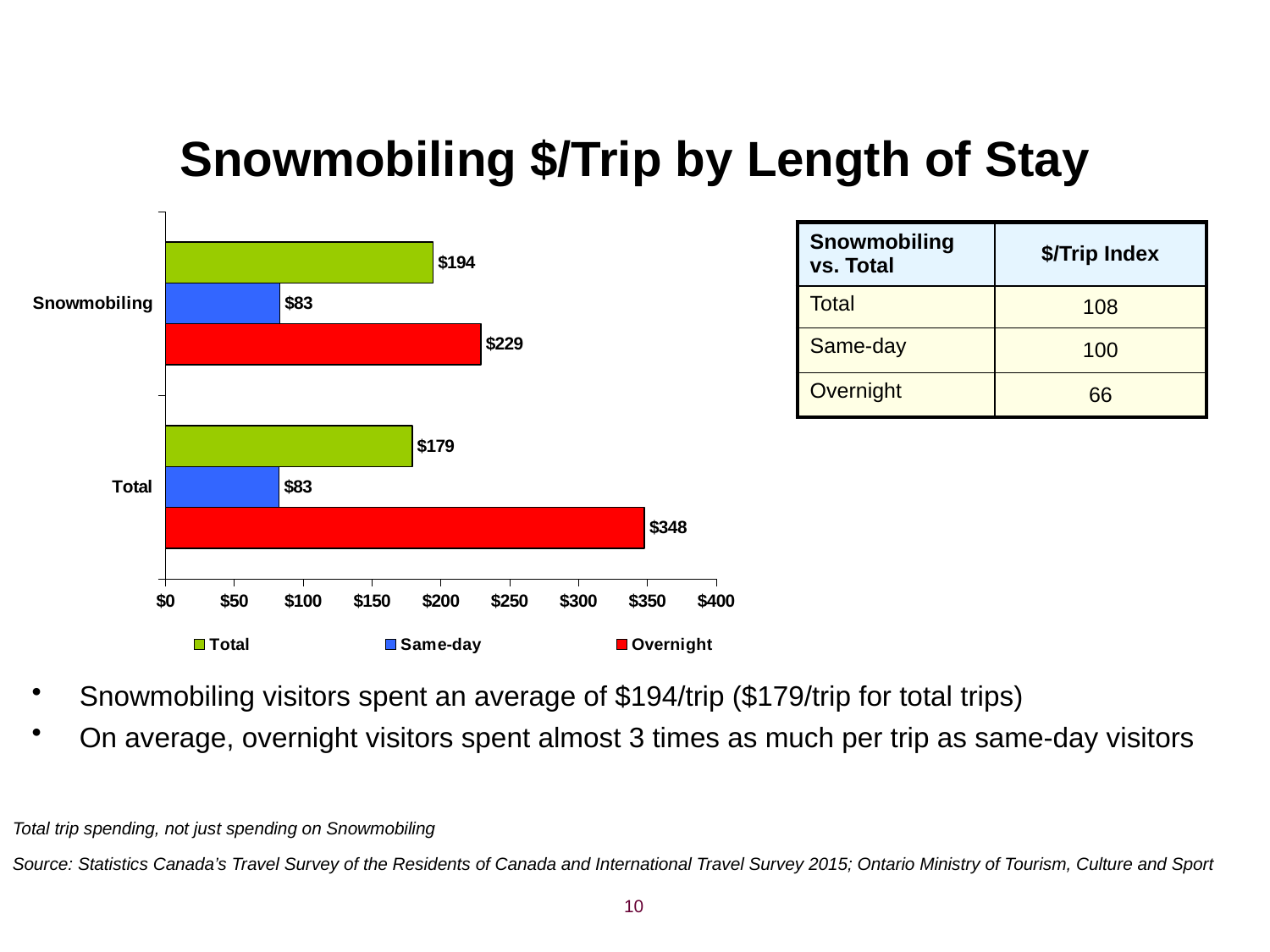
What is the difference between the Total series values for Snowmobiling and Total? $15 What is the Overnight $/trip value for Snowmobiling? $229 How many series does the legend list? 3 Which is larger: the Overnight value for Snowmobiling or the Overnight value for Total? Total What is the Total series value for the Total category? $179 Which series has the lowest value in the Snowmobiling category? Same-day What is the Same-day $/trip value for Snowmobiling? $83 What colour are the Overnight bars? Red What is the Overnight $/trip value for the Total category? $348 What is the difference between the Overnight values for Total and Snowmobiling? $119 Which series has the highest value in the Total category? Overnight What kind of chart is shown on the slide? Bar chart